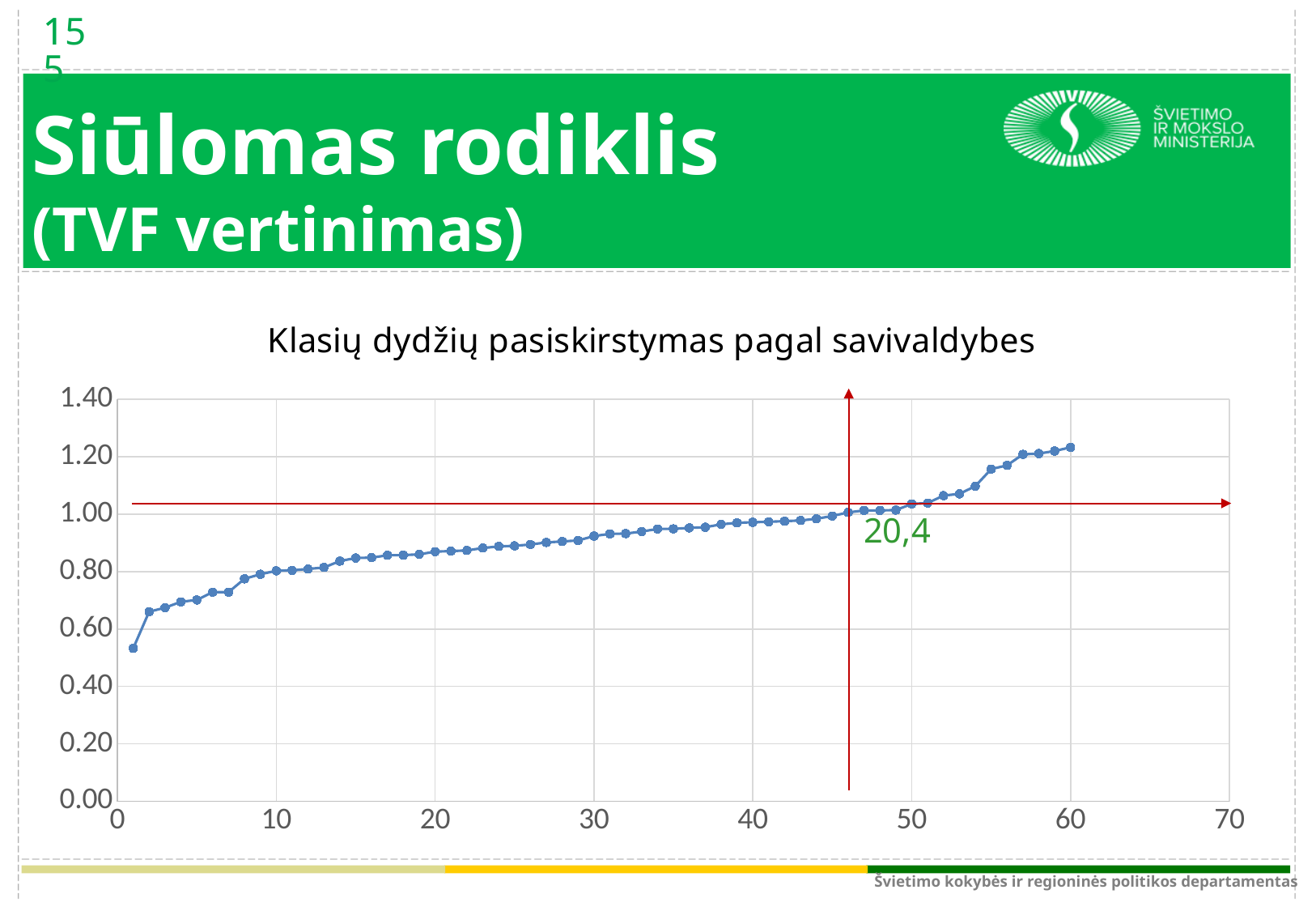
At which x position is the lowest plotted value? 1 Is the value of the point at x = 10 greater or less than 1.00? less Is the value of the first point (at x = 1) greater or less than 0.60? less Do the plotted values rise or fall as you move from left to right along the x axis? rise At which x position is the highest plotted value? 60 Which is larger, the value at x = 10 or the value at x = 50? x = 50 What is the title of the chart? Klasių dydžių pasiskirstymas pagal savivaldybes Is the value of the last point (at x = 60) greater or less than 1.20? greater What number is written in green next to the red vertical line on the chart? 20,4 What kind of chart is shown on the slide? line chart